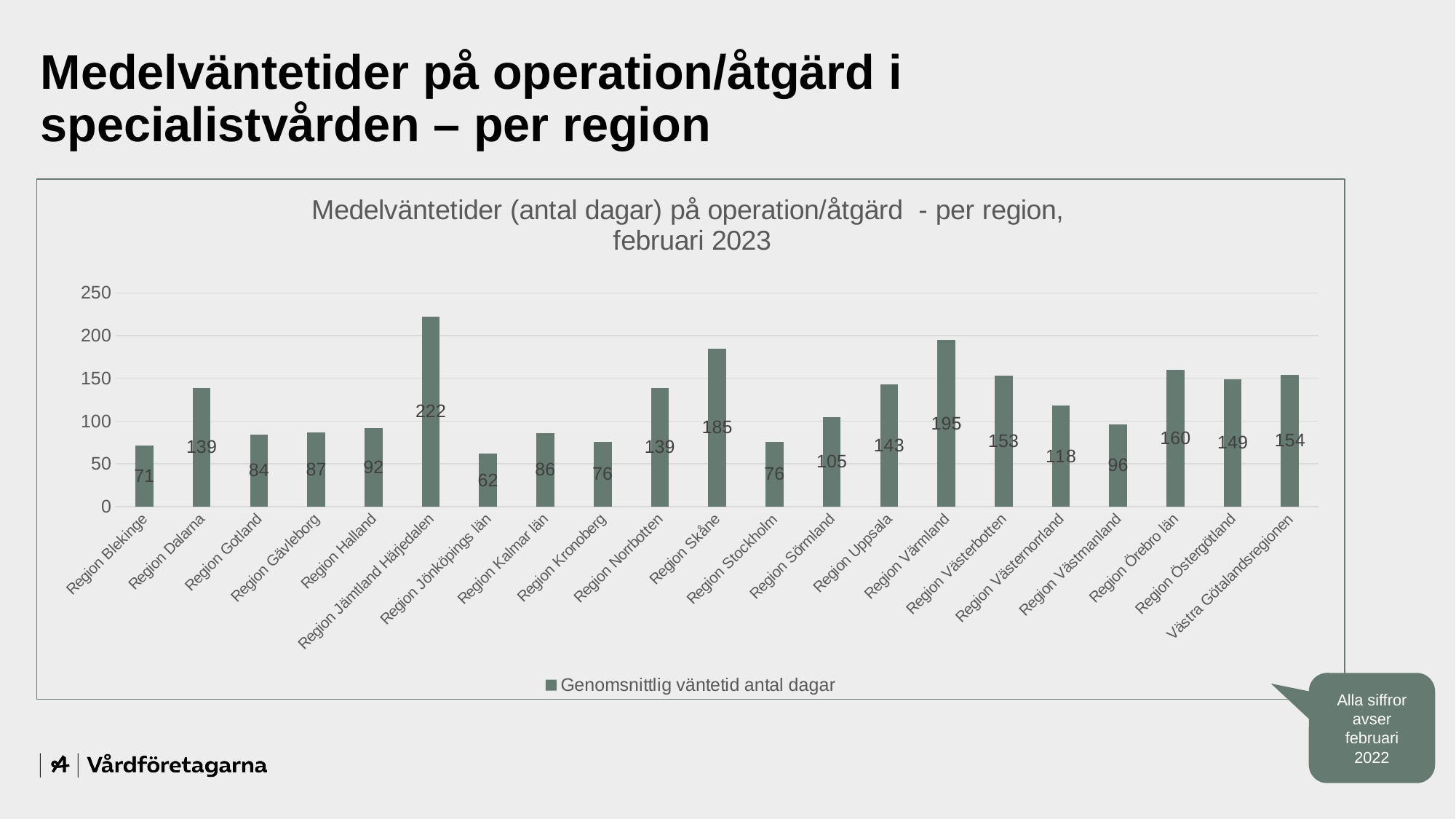
How many regions are shown in the chart? 21 What is the legend entry of the chart? Genomsnittlig väntetid antal dagar How many series does the legend list? 1 What kind of chart is shown on the slide? Bar chart What is the average waiting time (days) for Region Jämtland Härjedalen? 222 What is the difference in days between Region Värmland and Region Skåne? 10 Which has a higher value, Region Uppsala or Region Västerbotten? Region Västerbotten Is the value for Region Västernorrland greater or less than 100? greater What is the value shown for Region Örebro län? 160 Which region has the lowest average waiting time? Region Jönköpings län What is the value shown for Region Stockholm? 76 Which region has the highest average waiting time? Region Jämtland Härjedalen